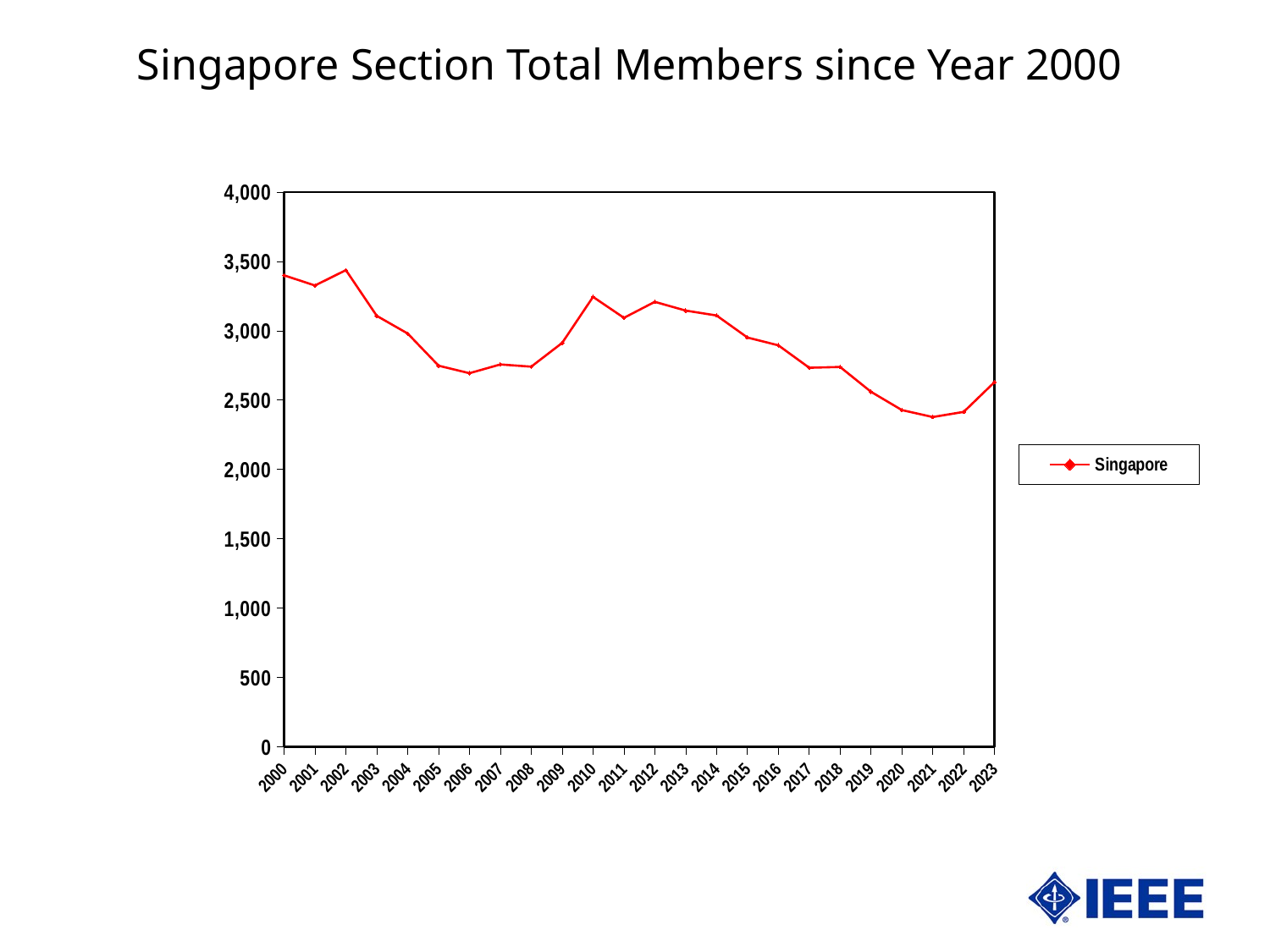
How many years are plotted along the x axis? 24 Do the values rise or fall from 2006 to 2010? rise Is the value for 2021 greater or less than 2,500? less Is the value for 2010 greater or less than 3,000? greater What kind of chart is shown on the slide? line chart Which year has the larger value, 2000 or 2023? 2000 Is the value for 2000 greater or less than 3,000? greater What is the title of the chart? Singapore Section Total Members since Year 2000 Which year has the larger value, 2009 or 2010? 2010 How many series does the legend list? 1 Do the values generally rise or fall from 2010 to 2021? fall